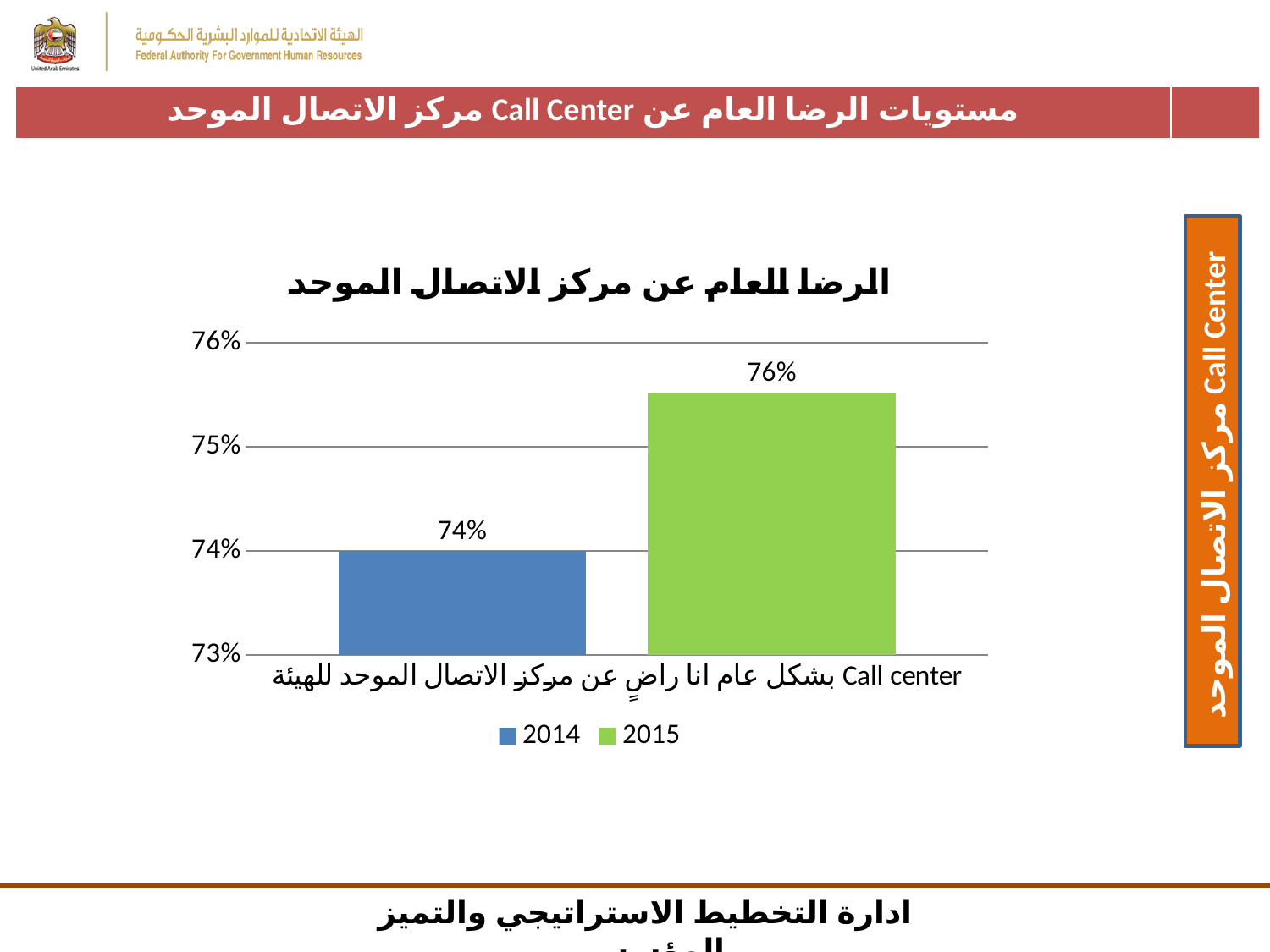
What colour is the bar for 2015? green What is the lowest value shown on the vertical axis? 73% Is the value for 2014 greater or less than 75%? less How many series does the legend list? 2 Which year has the higher value, 2014 or 2015? 2015 What is the difference between the 2015 and 2014 values? 2% Which series has the lowest value? 2014 Is the value for 2015 greater or less than 75%? greater What is the value for 2015? 76% What kind of chart is shown on the slide? bar chart Does the value rise or fall from 2014 to 2015? rise What is the value for 2014? 74%